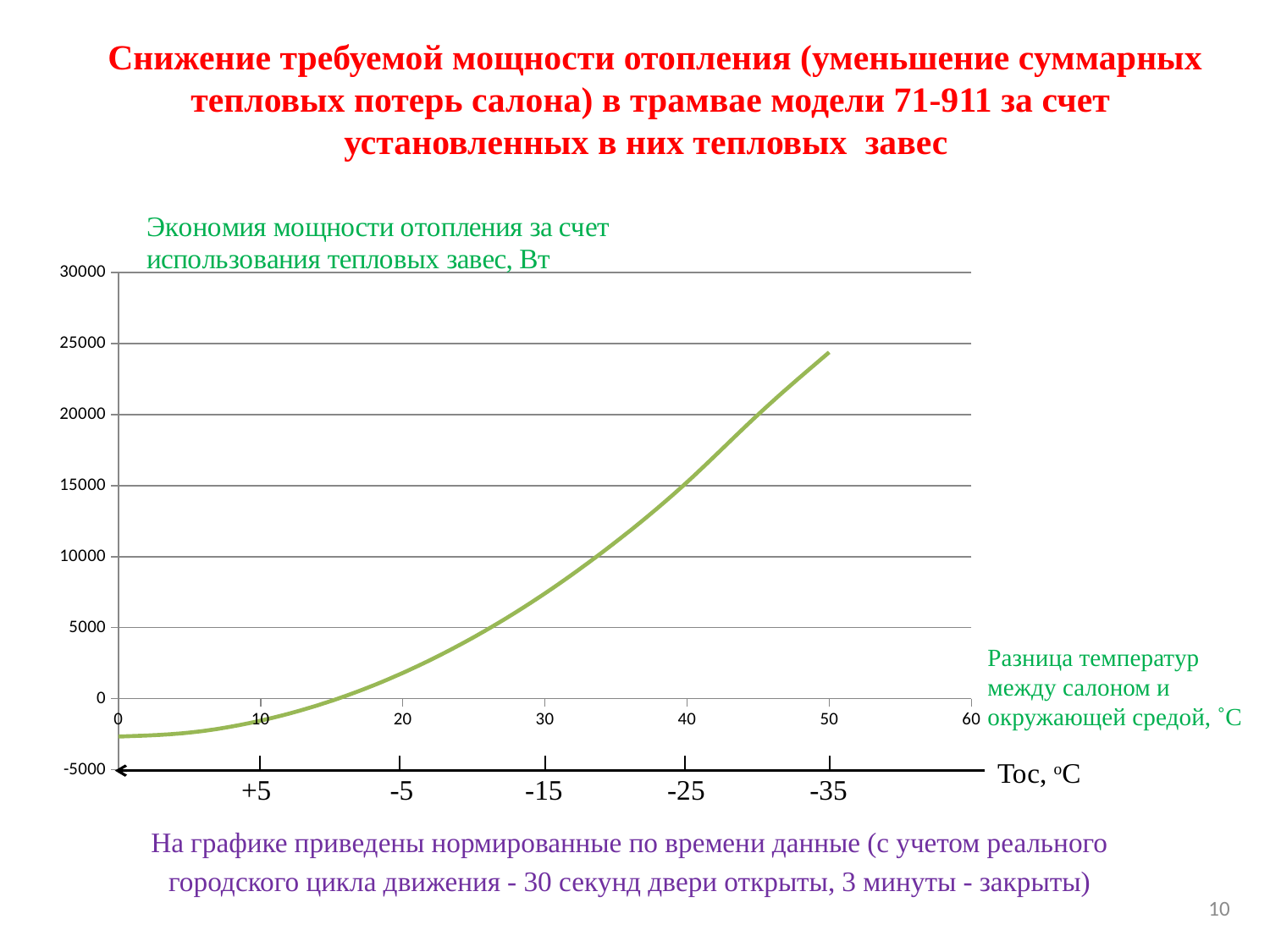
Is the value at a temperature difference of 30 °C greater or less than 5000? greater What kind of chart is shown on the slide? line chart At which temperature difference on the x axis does the curve have its lowest value? 0 What quantity does the green label above the chart say is plotted on the vertical axis? Экономия мощности отопления за счет использования тепловых завес, Вт Is the value at a temperature difference of 10 °C greater or less than 0? less What is the highest tick value shown on the vertical axis? 30000 Is the value at a temperature difference of 0 °C greater or less than 0? less Which is larger: the value at a temperature difference of 40 °C or at 20 °C? 40 °C Does the plotted value rise or fall as the temperature difference increases along the x axis? rises At which temperature difference on the x axis does the curve reach its highest value? 50